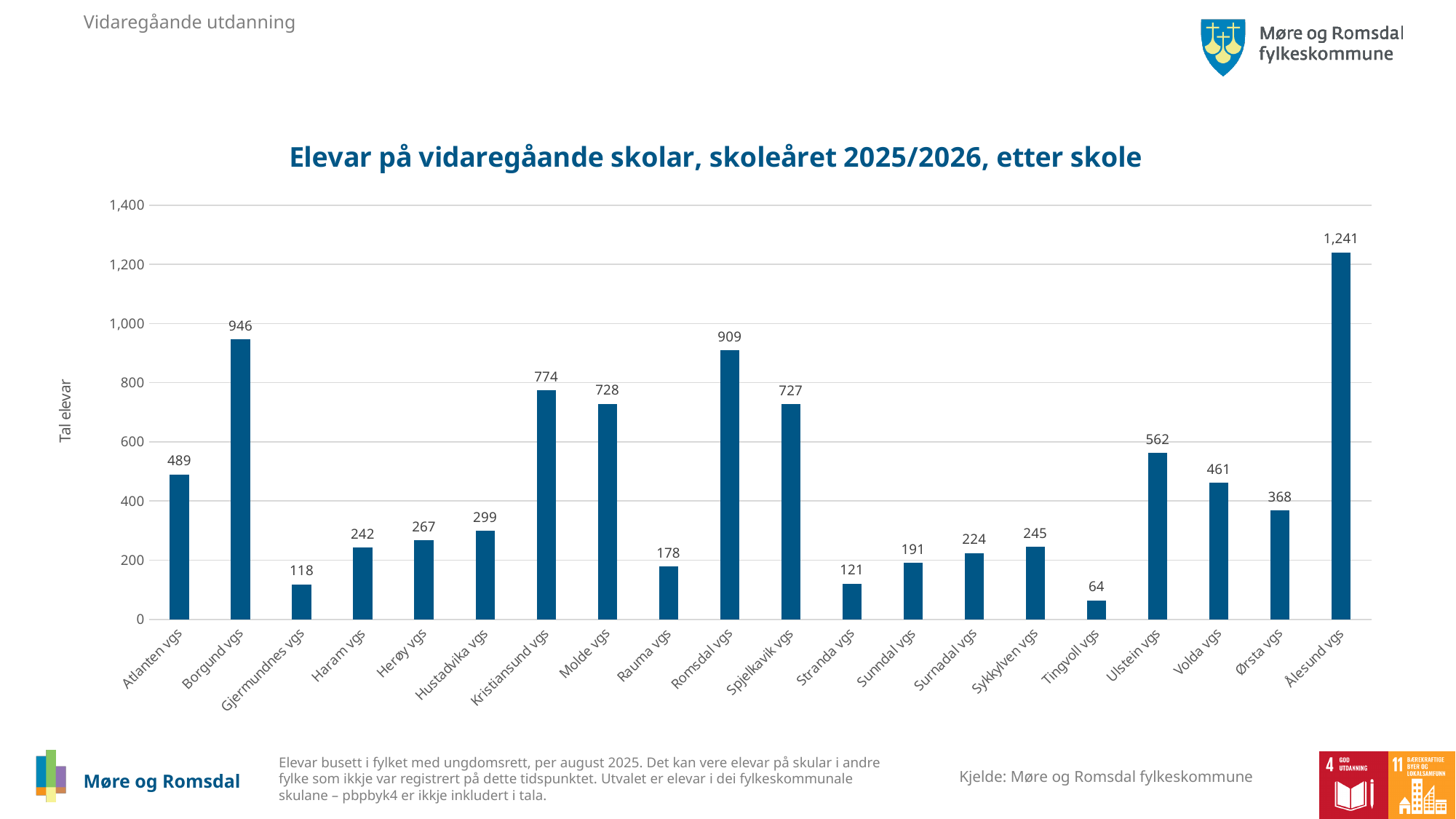
What is the difference between the values for Borgund vgs and Romsdal vgs? 37 Is the value for Ulstein vgs greater or less than 400? greater What is the label of the y axis of the chart? Tal elevar Which school has the highest number of students in the chart? Ålesund vgs What is the value shown for Tingvoll vgs? 64 How many students does Borgund vgs have according to the chart? 946 Which has a higher value, Kristiansund vgs or Molde vgs? Kristiansund vgs What is the value shown for Kristiansund vgs? 774 How many schools are shown on the x axis of the chart? 20 What type of chart is shown on the slide? Bar chart What is the difference between the values for Ålesund vgs and Borgund vgs? 295 Which school has the lowest number of students in the chart? Tingvoll vgs